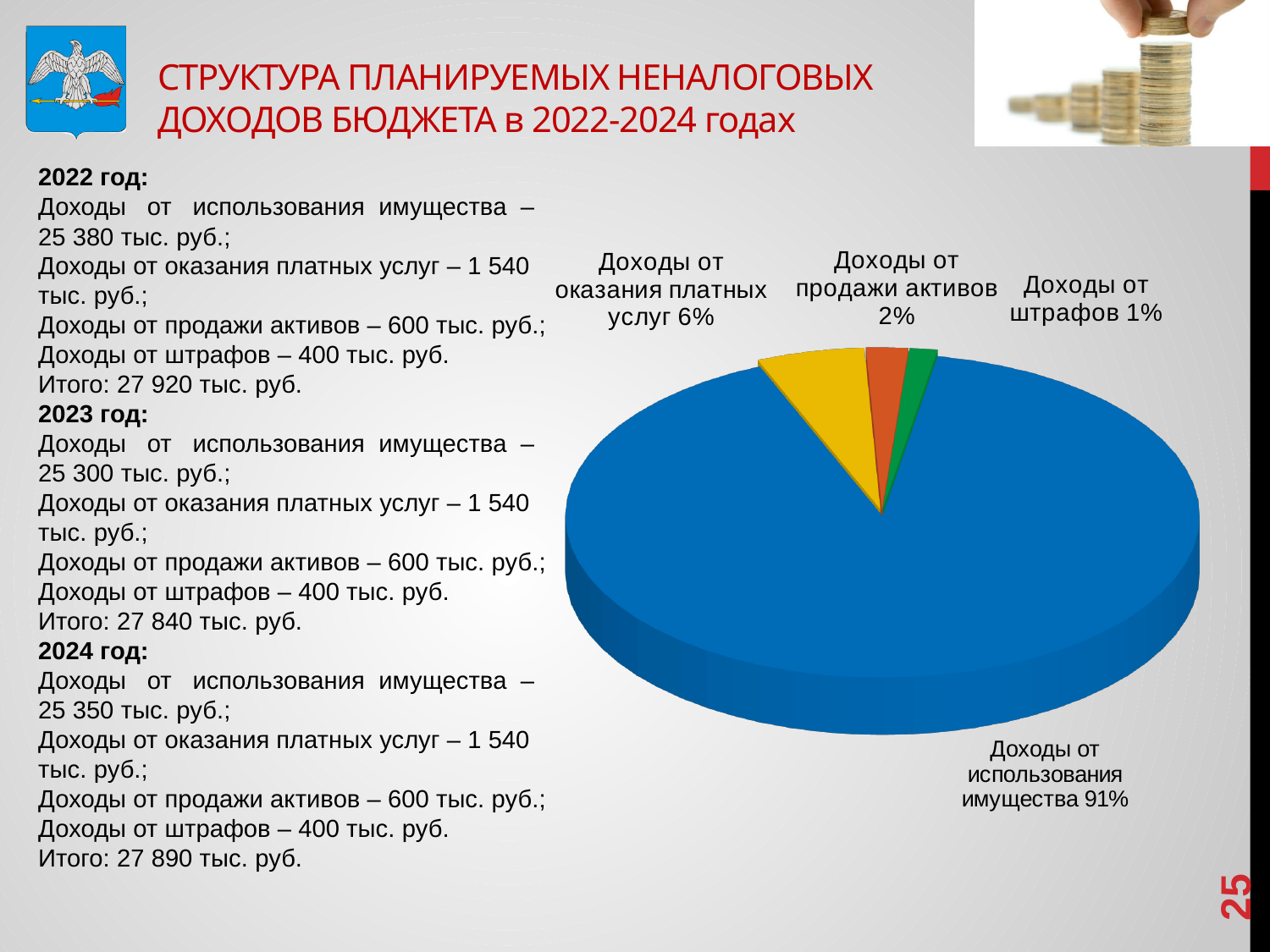
What kind of chart is shown on the slide? Pie chart Which is larger: the slice for "Доходы от продажи активов" or the slice for "Доходы от штрафов"? Доходы от продажи активов Which category has the largest slice of the pie? Доходы от использования имущества What is the difference in percentage points between "Доходы от оказания платных услуг" and "Доходы от продажи активов"? 4 What colour is the slice for "Доходы от использования имущества"? Blue What share of the pie does "Доходы от штрафов" have? 1% What share of the pie does "Доходы от оказания платных услуг" have? 6% Which category has the smallest slice of the pie? Доходы от штрафов What share of the pie does "Доходы от продажи активов" have? 2% How many slices does the pie chart have? 4 What is the difference in percentage points between "Доходы от использования имущества" and "Доходы от оказания платных услуг"? 85